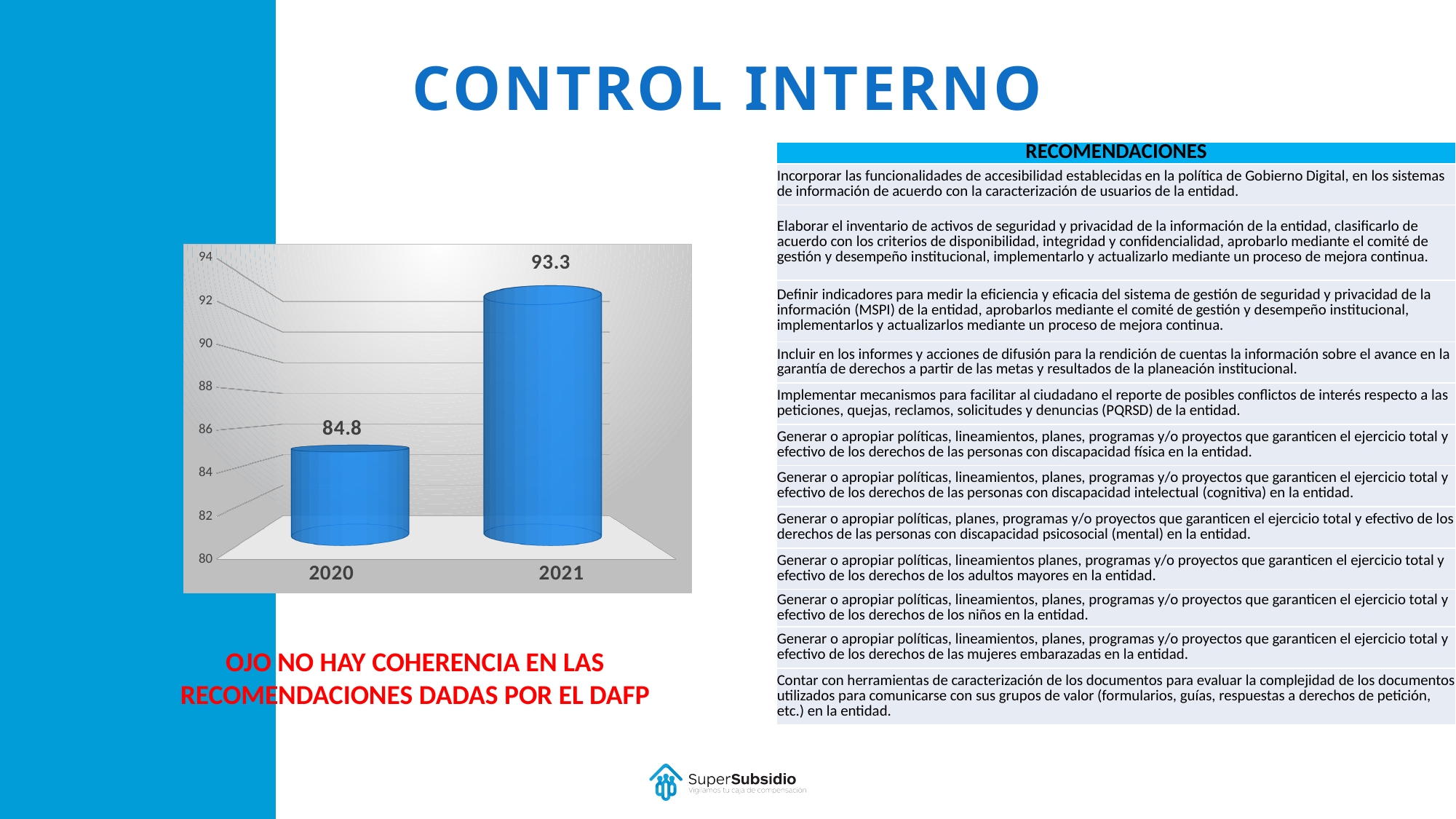
Do the values rise or fall from 2020 to 2021? rise How many categories are shown on the chart? 2 Is the value for 2021 greater or less than 92? greater What is the difference between the values for 2021 and 2020? 8.5 Is the value for 2020 greater or less than 86? less Which year has the lowest value? 2020 Which year has the highest value? 2021 What is the title of the slide containing the chart? CONTROL INTERNO Which is larger, the value for 2020 or the value for 2021? 2021 What is the value for 2021? 93.3 What is the value for 2020? 84.8 What kind of chart is shown on the slide? bar chart